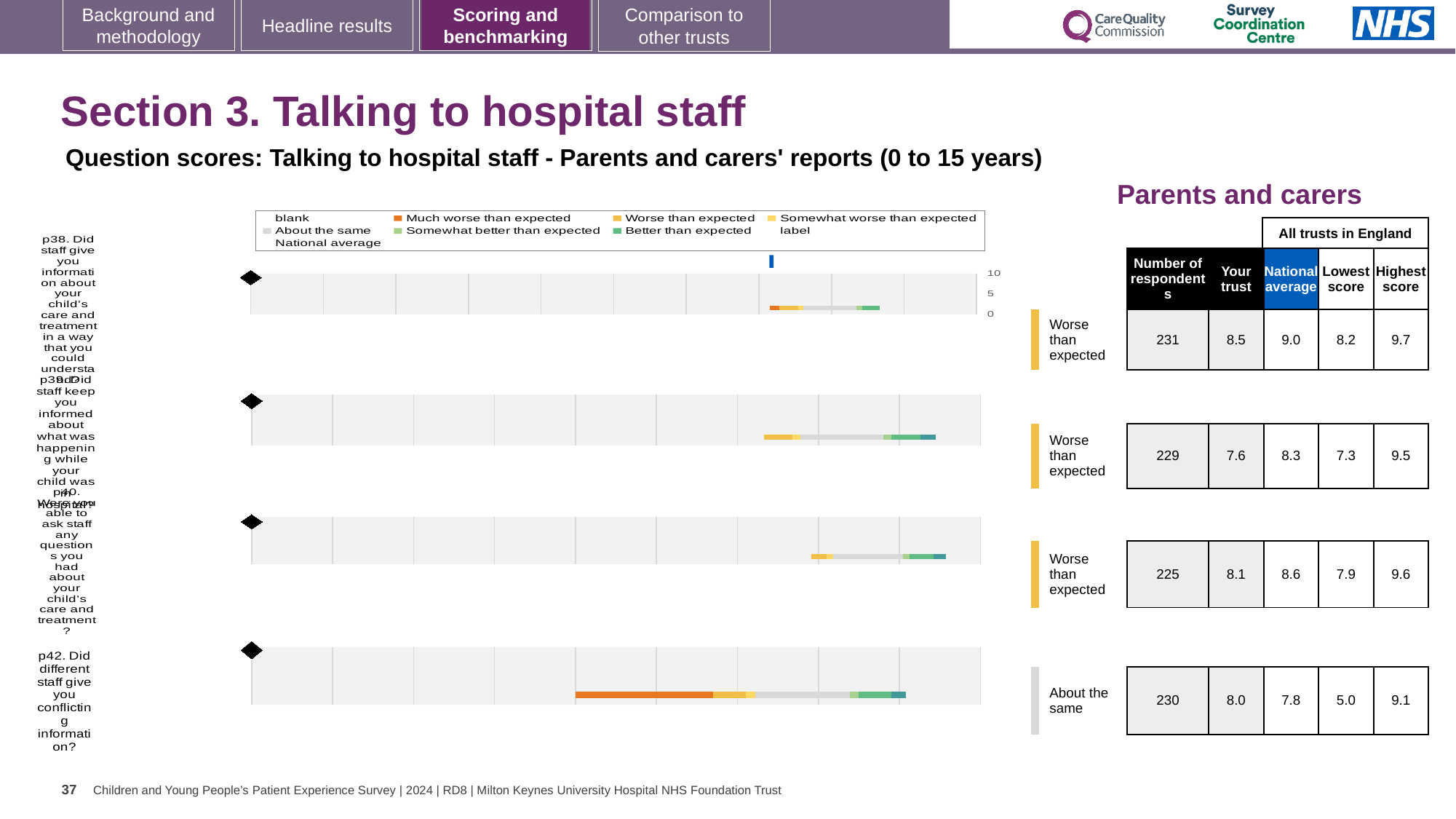
What is the national average score for question p39 (Did staff keep you informed about what was happening while your child was in hospital)? 8.3 Which question has the lowest number of respondents? p40 What is the difference between the national average and the 'Your trust' score for question p38? 0.5 How many respondents answered question p40 (Were you able to ask staff any questions you had about your child's care and treatment)? 225 What kind of chart is used to show the question scores on this slide? bar chart What is the 'Your trust' score for question p38 (Did staff give you information about your child's care and treatment in a way that you could understand)? 8.5 How many survey questions are plotted in the chart? 4 What benchmark category is shown for question p42? About the same Which question has the highest 'Your trust' score? p38 What is the lowest score across all trusts in England for question p42 (Did different staff give you conflicting information)? 5.0 What benchmark category is shown for question p39? Worse than expected For question p42, which is larger: the 'Your trust' score or the national average? Your trust